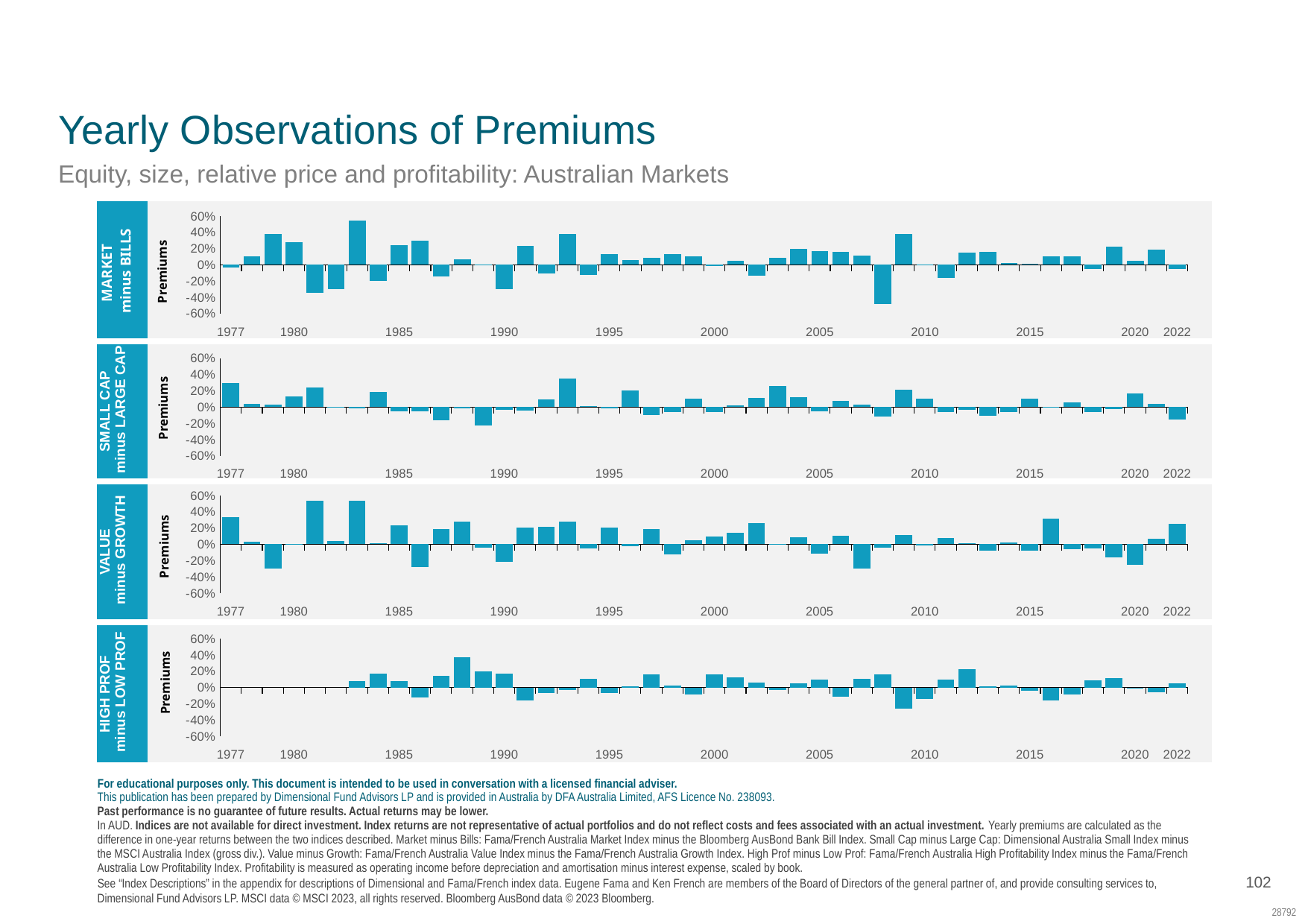
In the SMALL CAP minus LARGE CAP chart, which year has the lowest premium? 1989 In the MARKET minus BILLS chart, which year has the lowest premium? 2008 In the MARKET minus BILLS chart, which is larger, the value for 1983 or the value for 1981? 1983 In the HIGH PROF minus LOW PROF chart, is the value for 2009 greater or less than -10%? less In the HIGH PROF minus LOW PROF chart, which year has the highest premium? 1988 In the SMALL CAP minus LARGE CAP chart, which year has the highest premium? 1993 In the VALUE minus GROWTH chart, is the value for 1981 greater or less than 40%? greater What kind of chart is used in each of the four panels on the slide? Bar chart In the MARKET minus BILLS chart, is the value for 1983 greater or less than 40%? greater In the MARKET minus BILLS chart, which year has the highest premium? 1983 What is the label on the vertical axis of each chart? Premiums How many separate charts (panels) are shown on the slide? 4